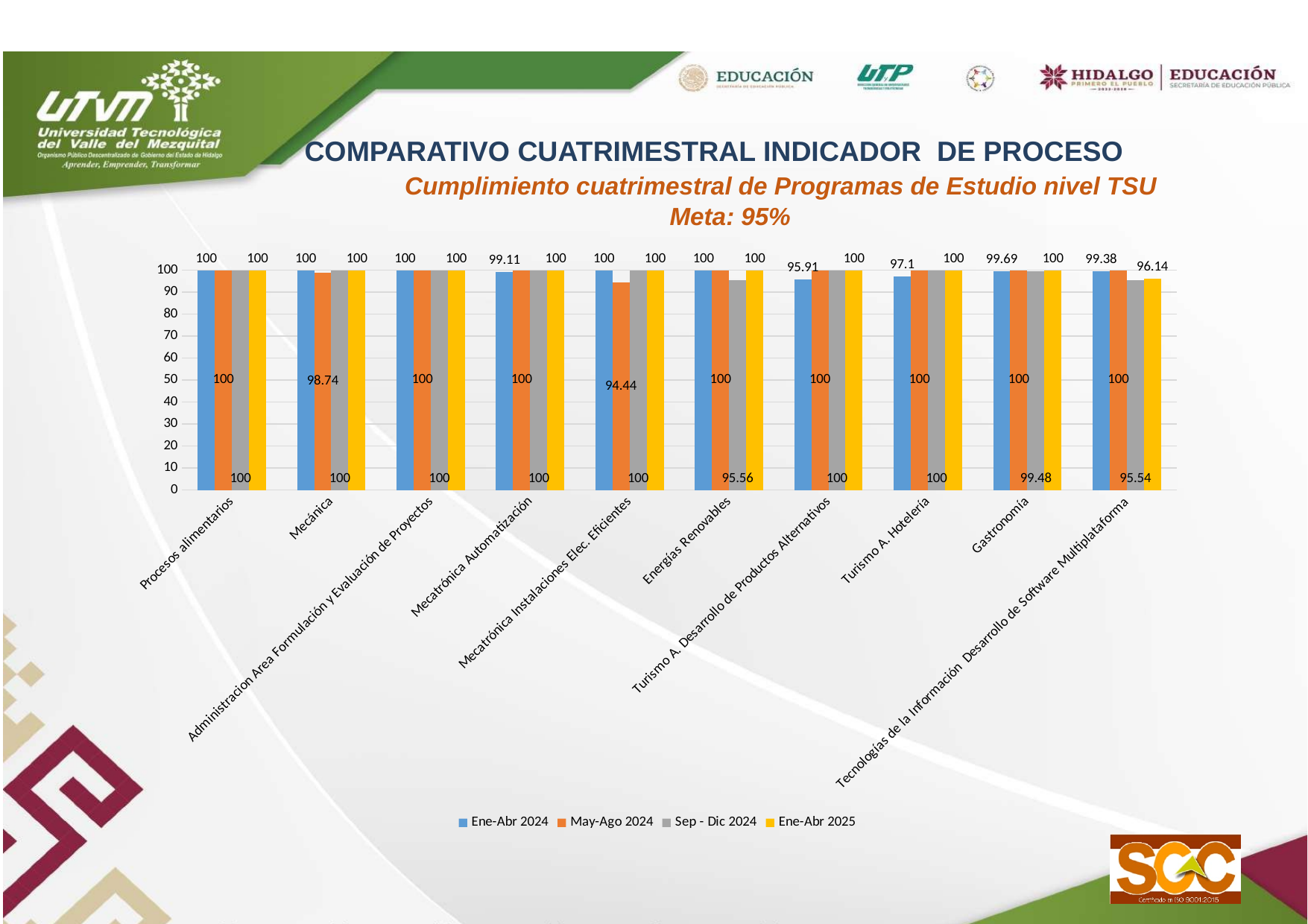
How many programs (categories) are shown along the x axis? 10 What is the May-Ago 2024 value for Mecatrónica Instalaciones Elec. Eficientes? 94.44 What type of chart is shown on the slide? bar chart What is the Ene-Abr 2025 value for Tecnologías de la Información Desarrollo de Software Multiplataforma? 96.14 Which program has the lowest May-Ago 2024 value? Mecatrónica Instalaciones Elec. Eficientes Which is larger for Gastronomía: the Ene-Abr 2024 value or the Sep - Dic 2024 value? Ene-Abr 2024 What is the Ene-Abr 2024 value for Turismo A. Desarrollo de Productos Alternativos? 95.91 What is the Sep - Dic 2024 value for Energías Renovables? 95.56 What is the May-Ago 2024 value for Mecánica? 98.74 How many series does the legend list? 4 What is the difference between the Ene-Abr 2024 value for Turismo A. Hotelería and the Ene-Abr 2024 value for Turismo A. Desarrollo de Productos Alternativos? 1.19 What target (Meta) is stated in the chart subtitle? 95%